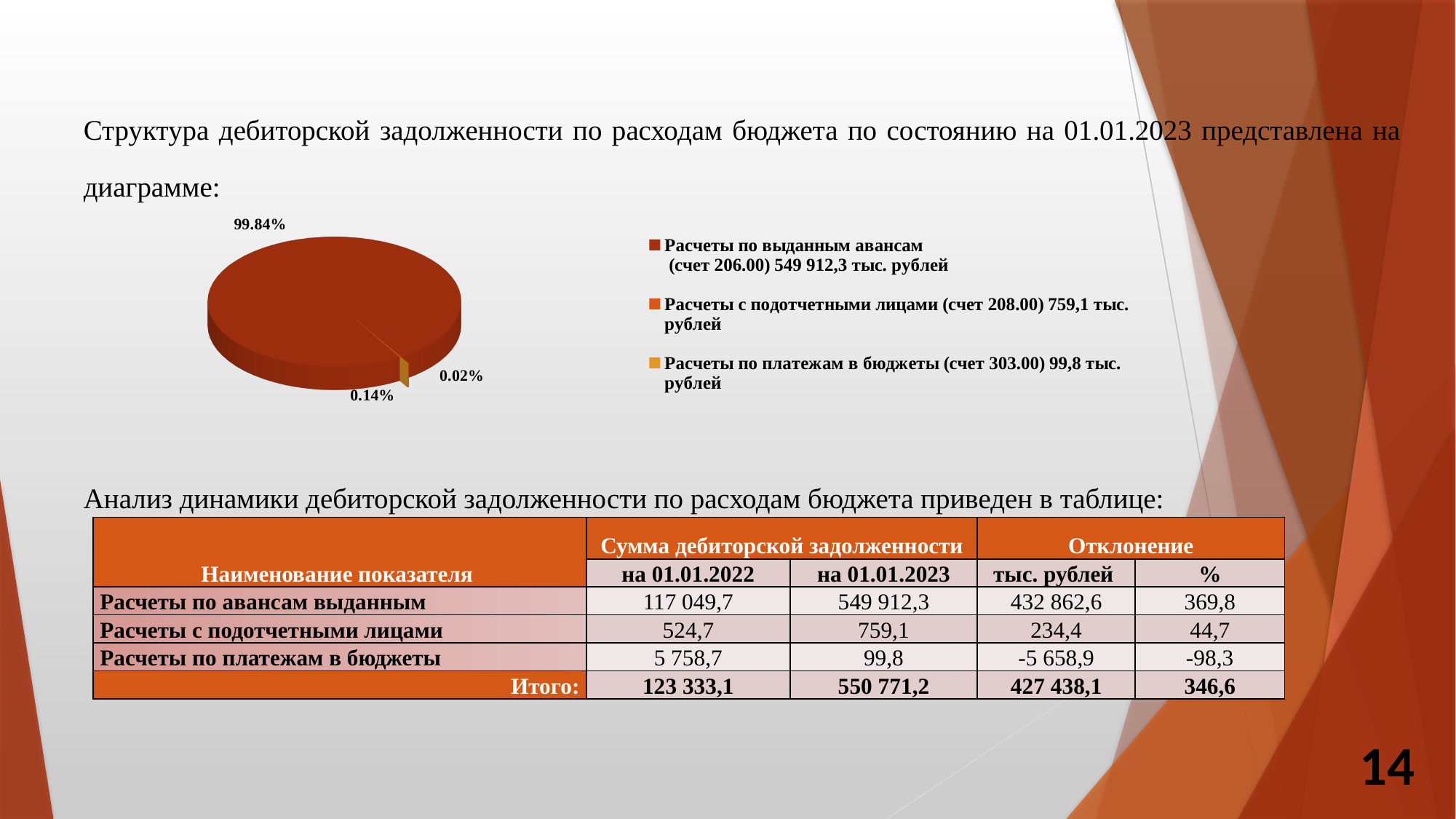
What kind of chart is shown on the slide? pie chart What share of the pie does 'Расчеты с подотчетными лицами (счет 208.00)' take? 0.14% What share of the pie does 'Расчеты по выданным авансам (счет 206.00)' take? 99.84% What is the difference in percentage points between the 0.14% slice and the 0.02% slice? 0.12% Which category has the largest slice of the pie chart? Расчеты по выданным авансам (счет 206.00) How many slices does the pie chart have? 3 Which category has the smallest slice of the pie chart? Расчеты по платежам в бюджеты (счет 303.00) What amount in тыс. рублей does the legend give for 'Расчеты по платежам в бюджеты (счет 303.00)'? 99,8 тыс. рублей How many entries does the legend of the pie chart list? 3 What amount in тыс. рублей does the legend give for 'Расчеты по выданным авансам (счет 206.00)'? 549 912,3 тыс. рублей Which slice is larger: 'Расчеты с подотчетными лицами' or 'Расчеты по платежам в бюджеты'? Расчеты с подотчетными лицами What share of the pie does 'Расчеты по платежам в бюджеты (счет 303.00)' take? 0.02%